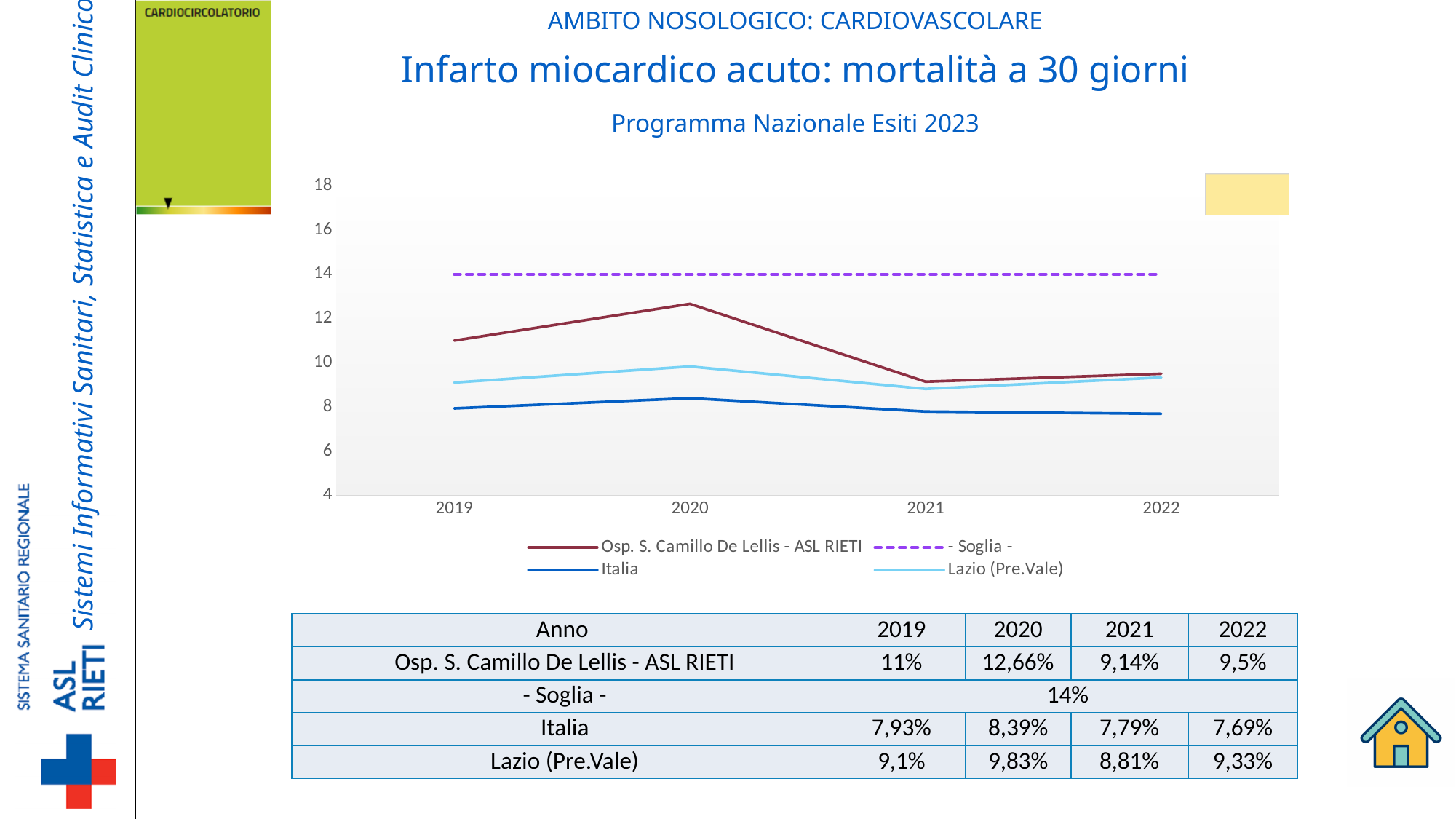
What is the value of the - Soglia - line? 14% What is the difference between the Osp. S. Camillo De Lellis - ASL RIETI value and the Italia value in 2019? 3,07% In which year does the Italia series reach its lowest value? 2022 How many series does the chart legend list? 4 Which is larger in 2022: the value for Osp. S. Camillo De Lellis - ASL RIETI or the value for Lazio (Pre.Vale)? Osp. S. Camillo De Lellis - ASL RIETI What is the value for Lazio (Pre.Vale) in 2021? 8,81% What kind of chart is shown on the slide? line chart In which year does the Osp. S. Camillo De Lellis - ASL RIETI series reach its highest value? 2020 What is the value for Osp. S. Camillo De Lellis - ASL RIETI in 2020? 12,66% What is the value for Italia in 2022? 7,69% How many years are shown on the x axis of the chart? 4 Is the value for Osp. S. Camillo De Lellis - ASL RIETI in 2020 greater or less than 14? less